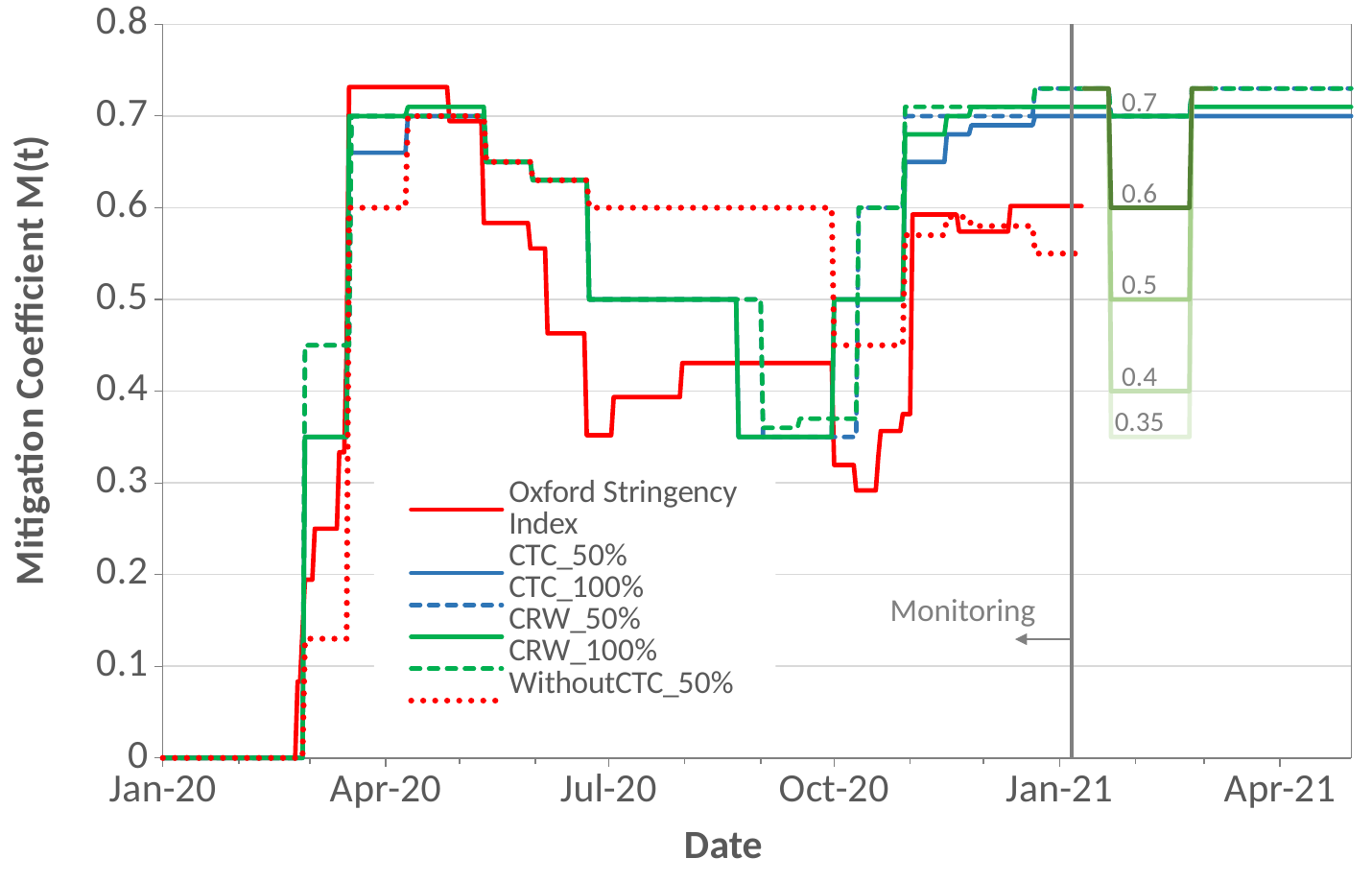
What kind of chart is shown on the slide? line chart What is the title of the y axis? Mitigation Coefficient M(t) At Jul-20, which is larger: WithoutCTC_50% or the Oxford Stringency Index? WithoutCTC_50% Is the peak value of the Oxford Stringency Index around Apr-20 greater or less than 0.7? greater What is the value of the Oxford Stringency Index at Jan-20? 0 Is the value for CRW_100% at Oct-20 greater or less than 0.4? less Is the value for the Oxford Stringency Index at Oct-20 greater or less than 0.4? less Do the values of the Oxford Stringency Index rise or fall between Jan-20 and Apr-20? rise How many series does the legend list? 6 What label is attached to the vertical line near Jan-21? Monitoring